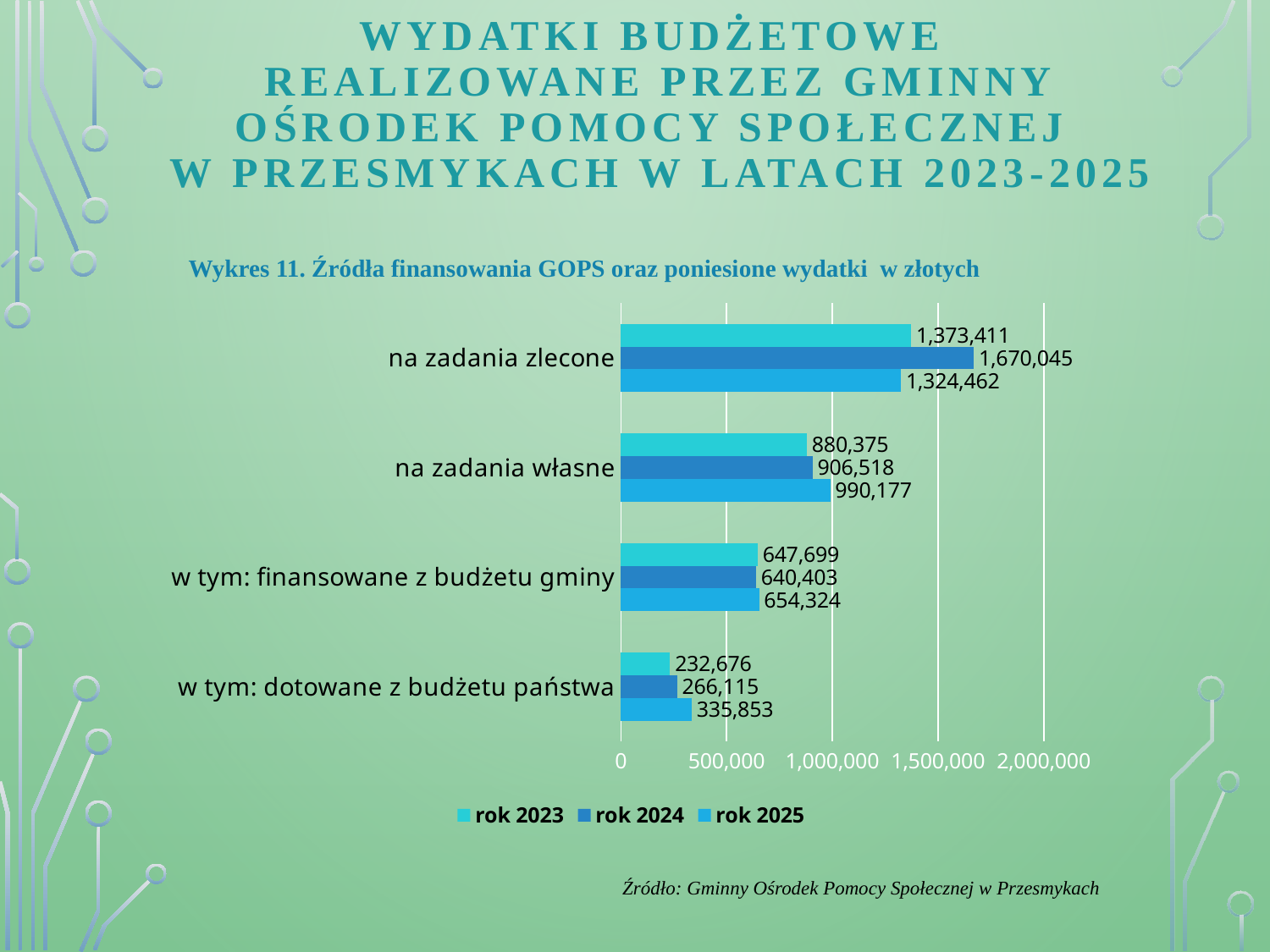
What is the difference between the rok 2024 and rok 2023 values for 'na zadania zlecone'? 296,634 How many categories are shown on the chart? 4 How many series does the legend list? 3 What is the value for 'na zadania zlecone' in rok 2024? 1,670,045 Which category has the highest value in rok 2024? na zadania zlecone What type of chart is shown on the slide? bar chart What is the value for 'w tym: dotowane z budżetu państwa' in rok 2023? 232,676 What is the title of the chart? Wykres 11. Źródła finansowania GOPS oraz poniesione wydatki w złotych Which is larger for 'na zadania własne': the rok 2023 value or the rok 2025 value? rok 2025 What is the value for 'na zadania własne' in rok 2025? 990,177 Which category has the lowest value in rok 2025? w tym: dotowane z budżetu państwa What is the value for 'w tym: finansowane z budżetu gminy' in rok 2024? 640,403